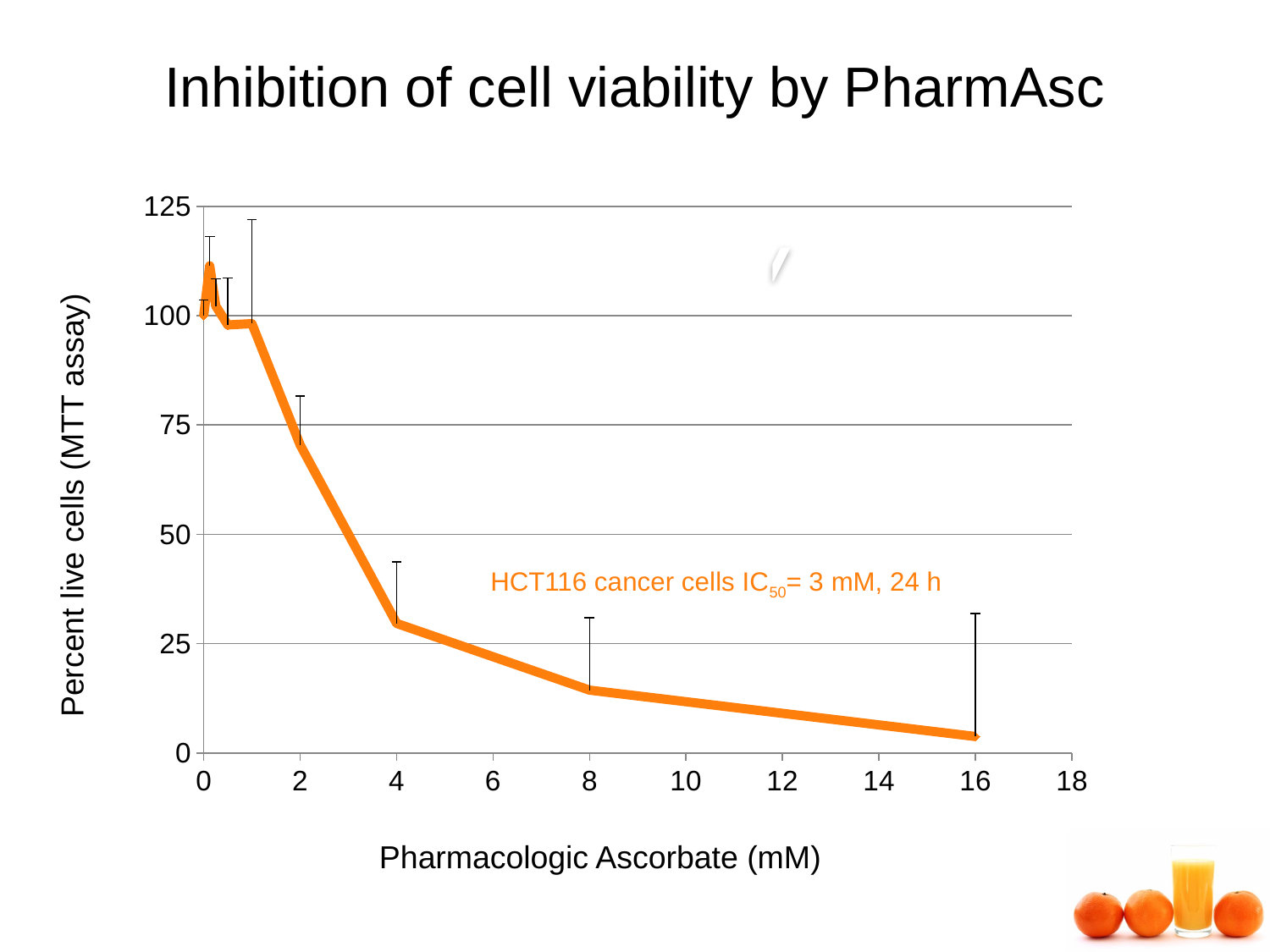
Is the percent live cells value at 4 mM greater or less than 50? less Do the percent live cells values rise or fall as the ascorbate concentration increases along the x axis? fall Is the percent live cells value at 1 mM greater or less than 75? greater What kind of chart is shown on the slide? line chart What is the label of the x axis? Pharmacologic Ascorbate (mM) Is the percent live cells value at 2 mM greater or less than 100? less What is the title of the chart? Inhibition of cell viability by PharmAsc According to the annotation on the chart, what is the IC50 for HCT116 cancer cells? 3 mM Which has a higher percent live cells value, 2 mM or 8 mM of pharmacologic ascorbate? 2 mM